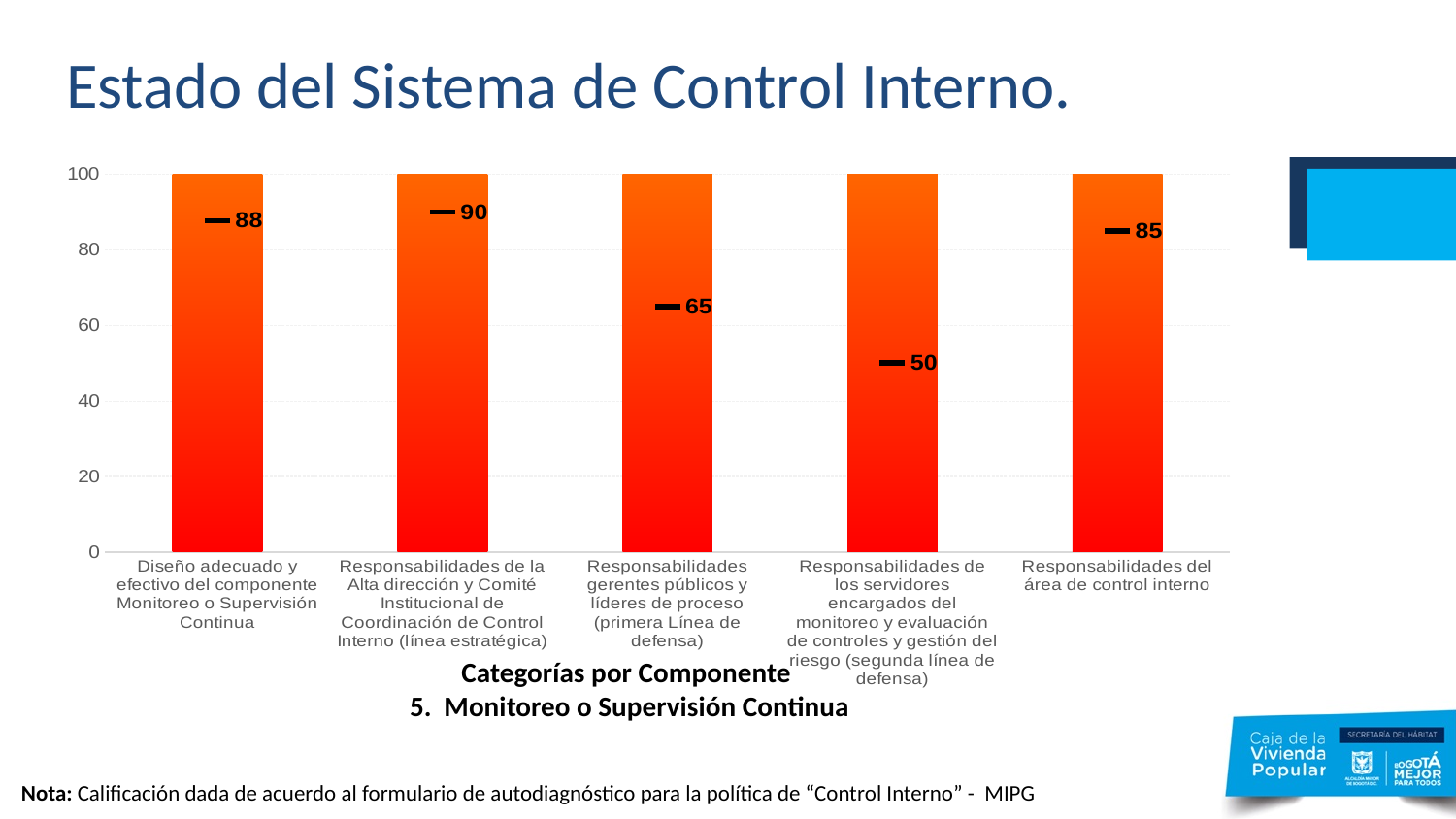
Which is larger: the value for 'Responsabilidades gerentes públicos y líderes de proceso' or the value for 'Responsabilidades del área de control interno'? Responsabilidades del área de control interno What value is shown for 'Diseño adecuado y efectivo del componente Monitoreo o Supervisión Continua'? 88 What value is shown for 'Responsabilidades de los servidores encargados del monitoreo y evaluación de controles y gestión del riesgo (segunda línea de defensa)'? 50 What is the difference between the values for 'Diseño adecuado y efectivo del componente Monitoreo o Supervisión Continua' and 'Responsabilidades del área de control interno'? 3 What is the title of the slide containing the chart? Estado del Sistema de Control Interno. What value is shown for 'Responsabilidades del área de control interno'? 85 How many categories are shown on the x axis? 5 Which category has the lowest value? Responsabilidades de los servidores encargados del monitoreo y evaluación de controles y gestión del riesgo (segunda línea de defensa) What value is shown for 'Responsabilidades gerentes públicos y líderes de proceso (primera Línea de defensa)'? 65 What is the difference between the highest value (90) and the lowest value (50)? 40 Which category has the highest value? Responsabilidades de la Alta dirección y Comité Institucional de Coordinación de Control Interno (línea estratégica) What kind of chart is shown on the slide? Bar chart